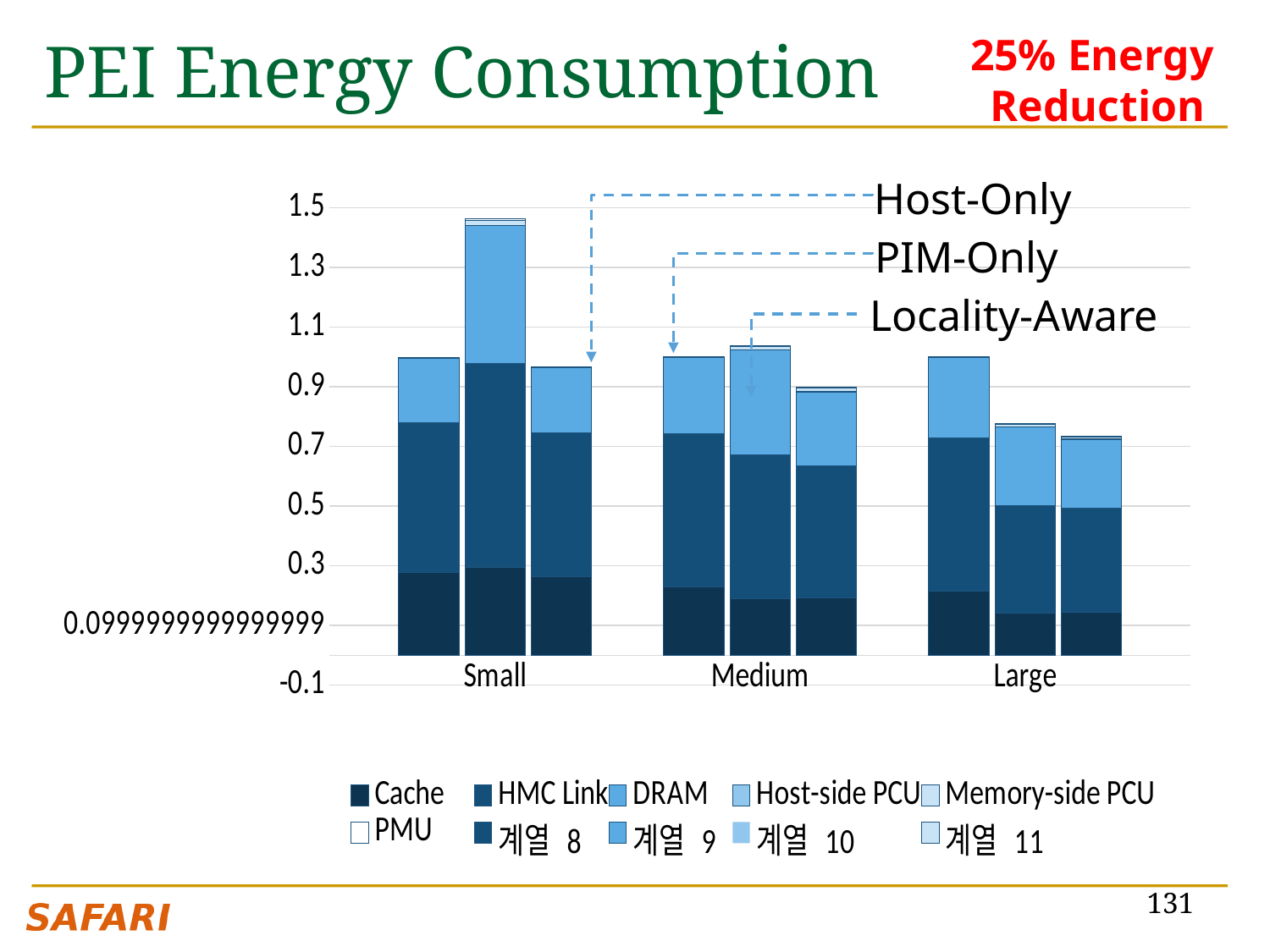
Which x-axis category contains the tallest bar in the chart? Small Is the PIM-Only bar for Medium greater or less than 0.9? greater What kind of chart is shown on the slide? Stacked bar chart Do the Locality-Aware bars rise or fall from Small to Large? fall How many categories are shown on the x axis of the chart? 3 Is the PIM-Only bar for Small greater or less than 1.3? greater Which configuration has the tallest bar in the Small group? PIM-Only Is the Locality-Aware bar for Large greater or less than 0.9? less How many series does the chart's legend list? 10 In the Large group, which is larger: the Host-Only bar or the PIM-Only bar? Host-Only What energy reduction is highlighted in red at the top right of the slide? 25% Energy Reduction What is the title of the chart on the slide? PEI Energy Consumption